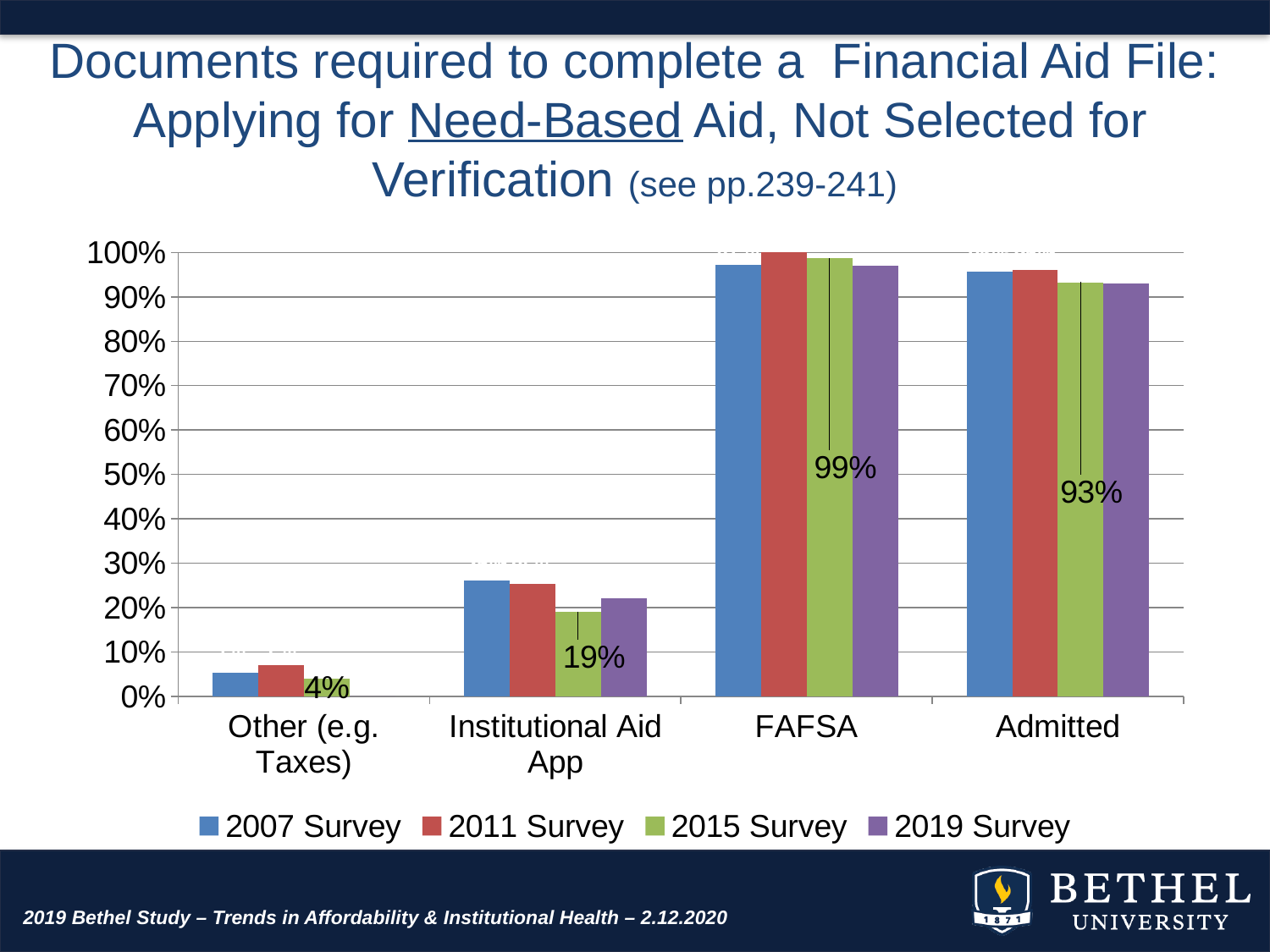
Which category has the lowest value in the 2015 Survey? Other (e.g. Taxes) What is the value for Other (e.g. Taxes) in the 2015 Survey? 4% Which is larger for the 2019 Survey: FAFSA or Admitted? FAFSA What is the value for Admitted in the 2015 Survey? 93% How many series does the legend list? 4 What is the value for FAFSA in the 2015 Survey? 99% Which category has the highest value in the 2015 Survey? FAFSA What is the value for Institutional Aid App in the 2015 Survey? 19% Is the 2019 Survey value for Institutional Aid App greater or less than 30%? less How many document categories are shown on the x axis? 4 What is the difference between the 2015 Survey values for FAFSA and Admitted? 6 percentage points What kind of chart is shown on the slide? bar chart